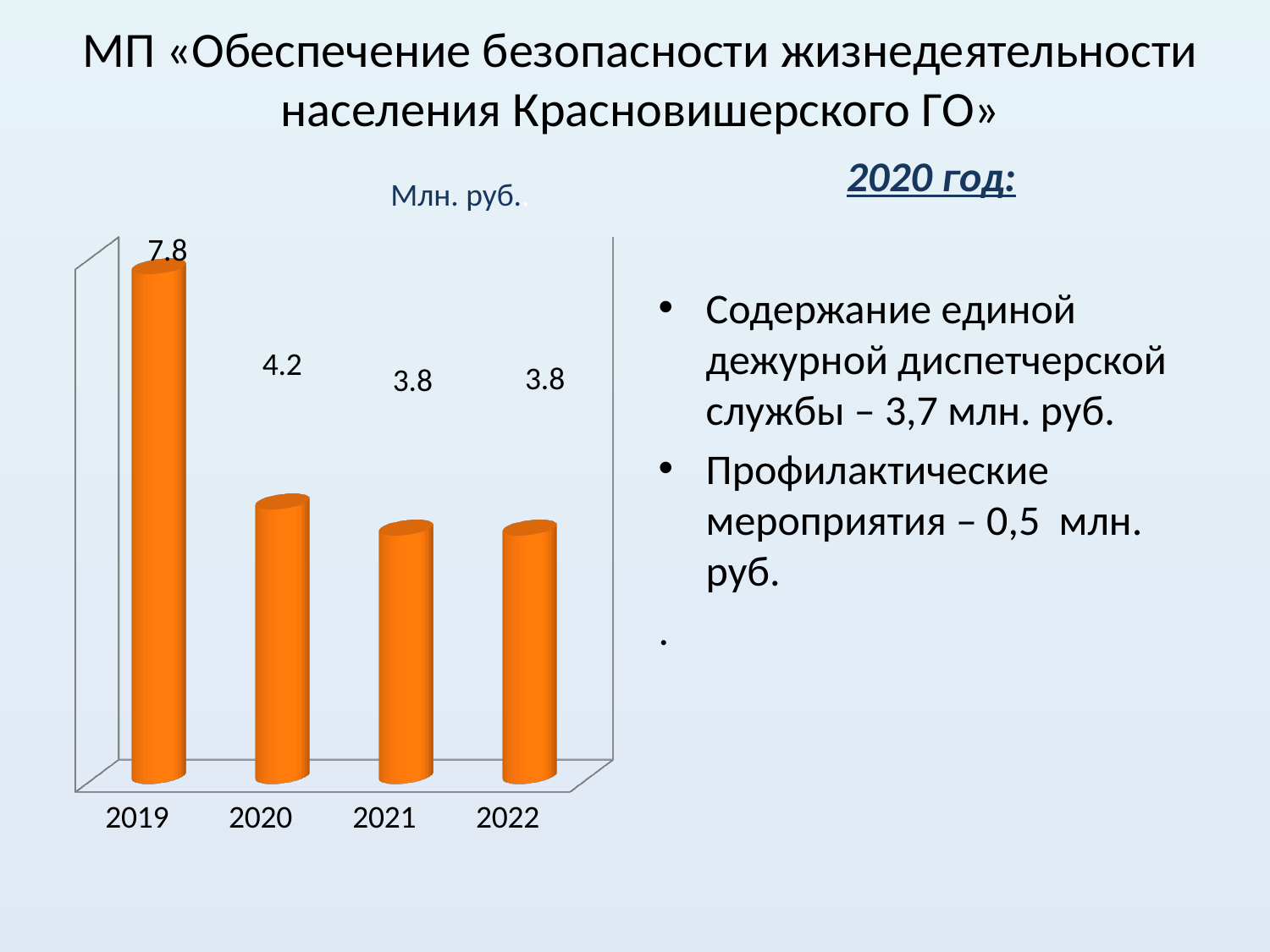
What is the value for 2019? 7.8 What is the title of the chart? Млн. руб. What is the value for 2020? 4.2 What kind of chart is shown on the slide? bar chart Which year has the highest value? 2019 What is the difference between the values for 2020 and 2021? 0.4 How many years are shown on the chart? 4 Do the values generally rise or fall from 2019 to 2022? fall What is the value for 2022? 3.8 Which is larger, the value for 2019 or the value for 2022? 2019 What is the difference between the values for 2019 and 2020? 3.6 What is the value for 2021? 3.8